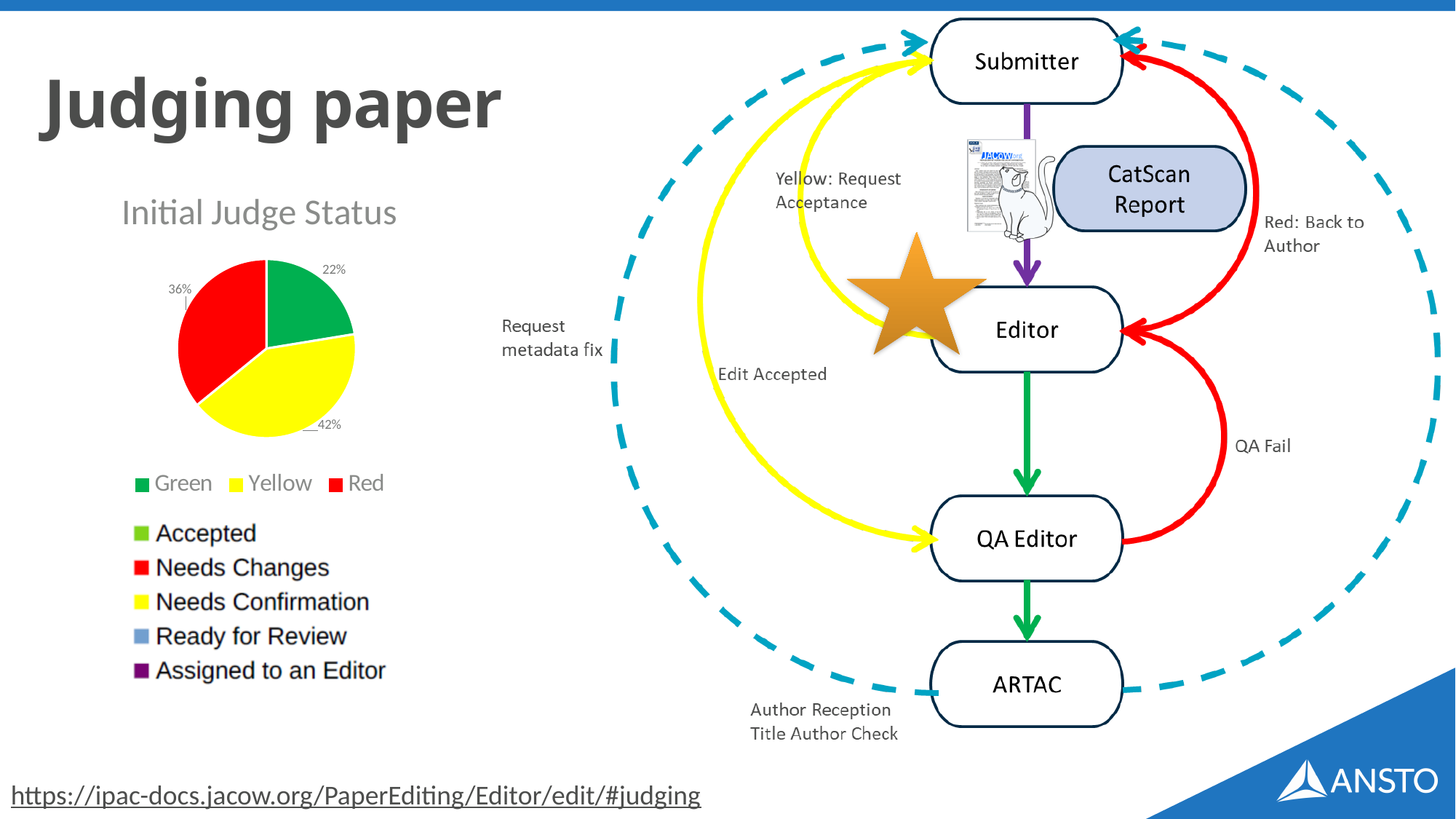
In the Initial Judge Status pie chart, what is the difference in percentage points between Yellow and Red? 6 In the Initial Judge Status pie chart, what percentage is shown for Red? 36% How many entries does the legend of the Initial Judge Status pie chart list? 3 In the Initial Judge Status pie chart, what is the difference in percentage points between Red and Green? 14 What kind of chart is shown under the title "Initial Judge Status"? pie chart In the Initial Judge Status pie chart, which category has the smallest share? Green In the Initial Judge Status pie chart, what percentage is shown for Yellow? 42% In the Initial Judge Status pie chart, which category has the largest share? Yellow In the Initial Judge Status pie chart, which is larger, the Red share or the Green share? Red In the Initial Judge Status pie chart, what percentage is shown for Green? 22% What is the title of the pie chart on the slide? Initial Judge Status How many slices does the Initial Judge Status pie chart have? 3